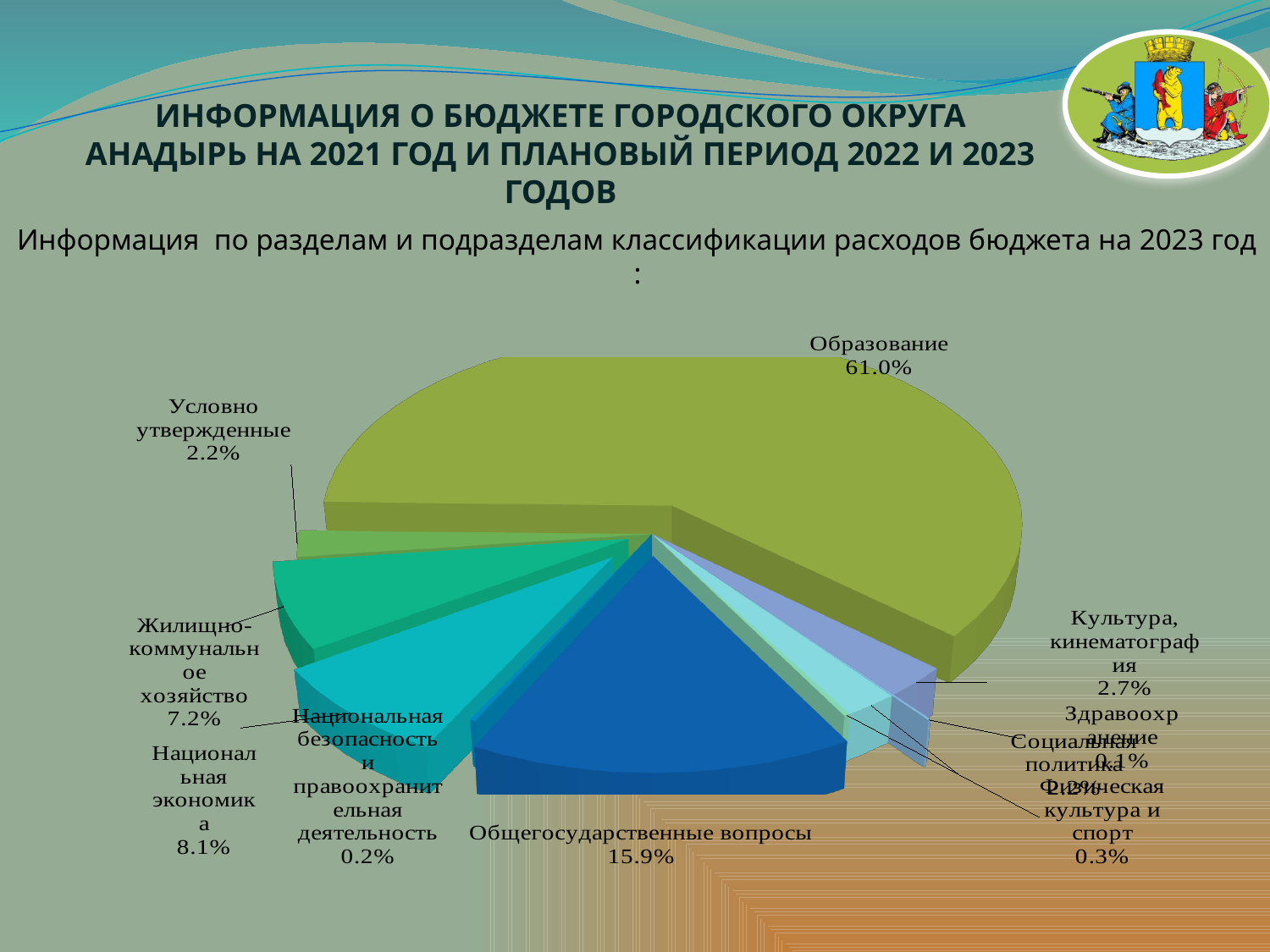
What percentage is given for Условно утвержденные? 2.2% What type of chart is used on the slide? Pie chart What share is shown for Культура, кинематография? 2.7% What percentage is labelled for Жилищно-коммунальное хозяйство? 7.2% Which section has the largest share of the 2023 budget expenditure? Образование Which is larger: the share for Национальная экономика or for Жилищно-коммунальное хозяйство? Национальная экономика What is the share for Национальная экономика? 8.1% By how many percentage points does Образование exceed Общегосударственные вопросы? 45.1 percentage points What share of the 2023 budget expenditure does Образование (Education) account for? 61.0% How many sections (slices) are shown in the pie chart? 10 Which section has the smallest share in the pie chart? Здравоохранение What percentage is shown for Общегосударственные вопросы? 15.9%